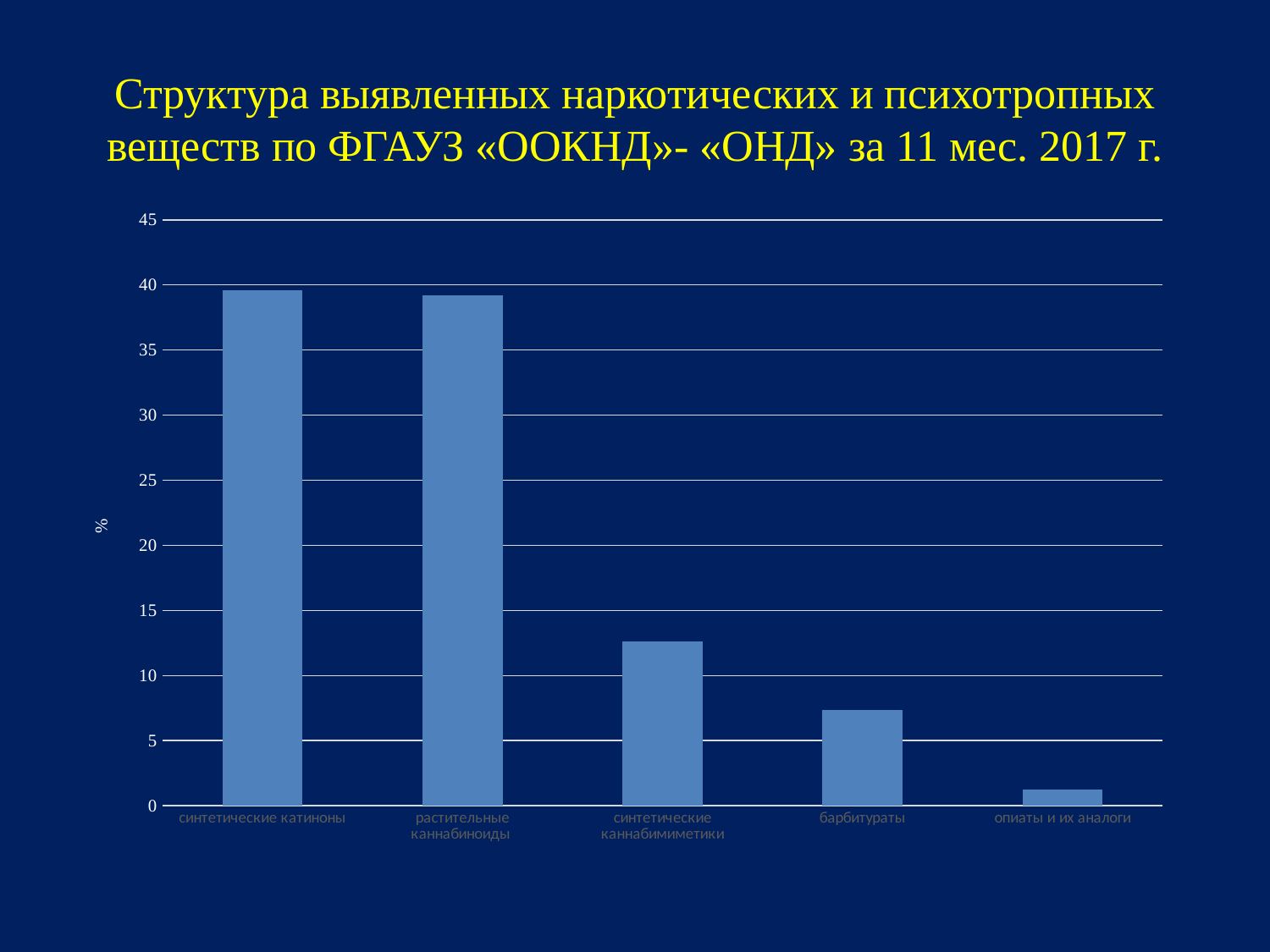
How many categories are shown on the x axis of the chart? 5 Do the bar values rise or fall from left to right along the x axis? fall Is the value for растительные каннабиноиды greater or less than 40? less Is the value for синтетические катиноны greater or less than 35? greater Is the value for барбитураты greater or less than 5? greater Which category has the lowest value in the chart? опиаты и их аналоги What kind of chart is shown on the slide? bar chart Which is larger, the value for барбитураты or the value for опиаты и их аналоги? барбитураты Which is larger, the value for синтетические каннабимиметики or the value for барбитураты? синтетические каннабимиметики What is the label on the vertical axis of the chart? %